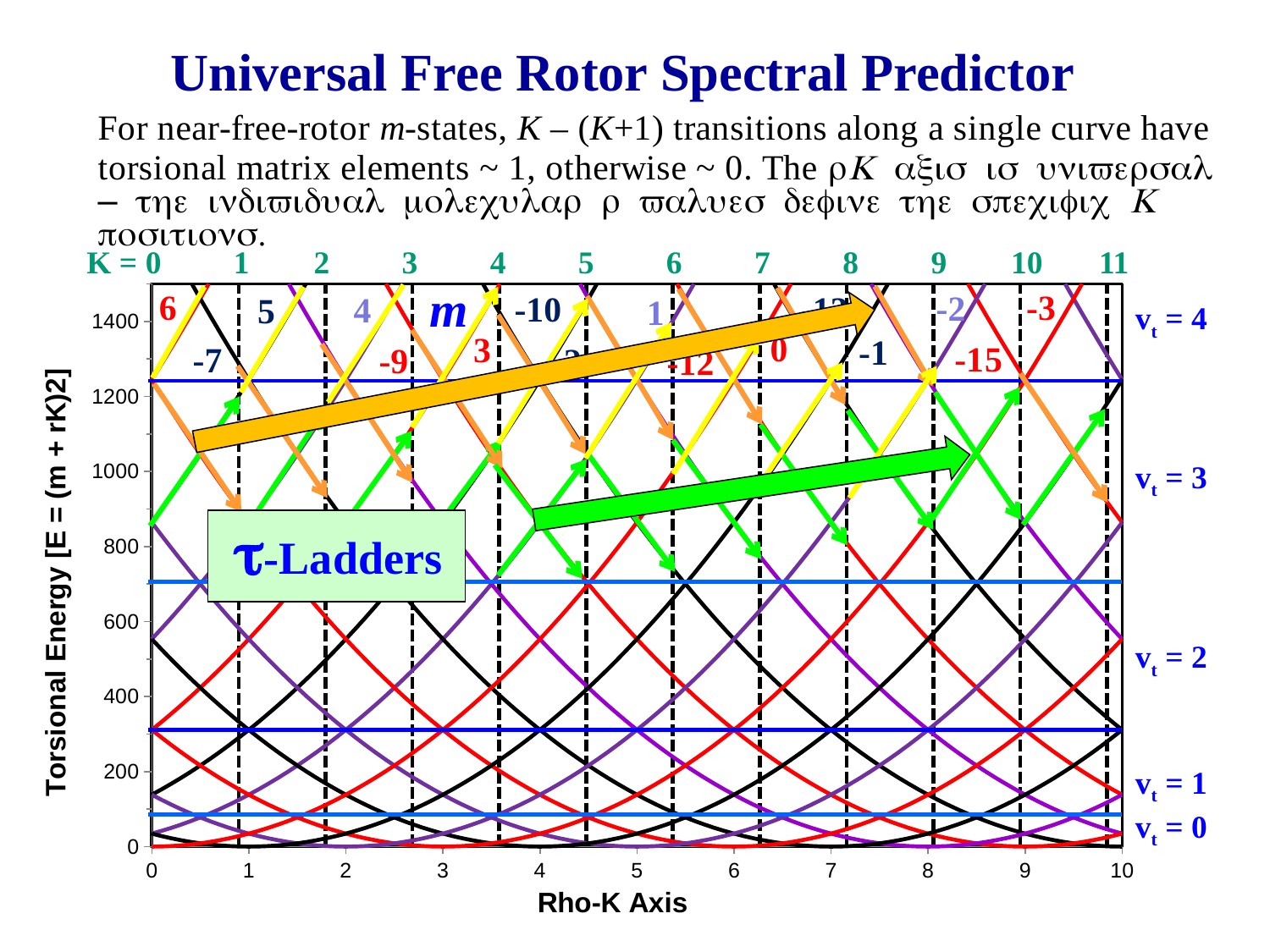
How many v_t levels are labeled on the right side of the chart? 5 What is the highest tick value shown on the y axis of the chart? 1400 What kind of chart is shown on the slide? line chart Is the horizontal line labeled v_t = 2 at a torsional energy greater or less than 200? greater Is the horizontal line labeled v_t = 3 at a torsional energy greater or less than 800? less Which labeled v_t level lies at the highest torsional energy on the chart? v_t = 4 Which labeled v_t level lies at the lowest torsional energy on the chart? v_t = 0 What is the title of the x axis of the chart? Rho-K Axis Is the horizontal line labeled v_t = 4 at a torsional energy greater or less than 1200? greater What is the highest tick value shown on the x axis of the chart? 10 What is the title of the y axis of the chart? Torsional Energy [E = (m + rK)2] How many K values are labeled along the top of the chart (K = 0 through 11)? 12